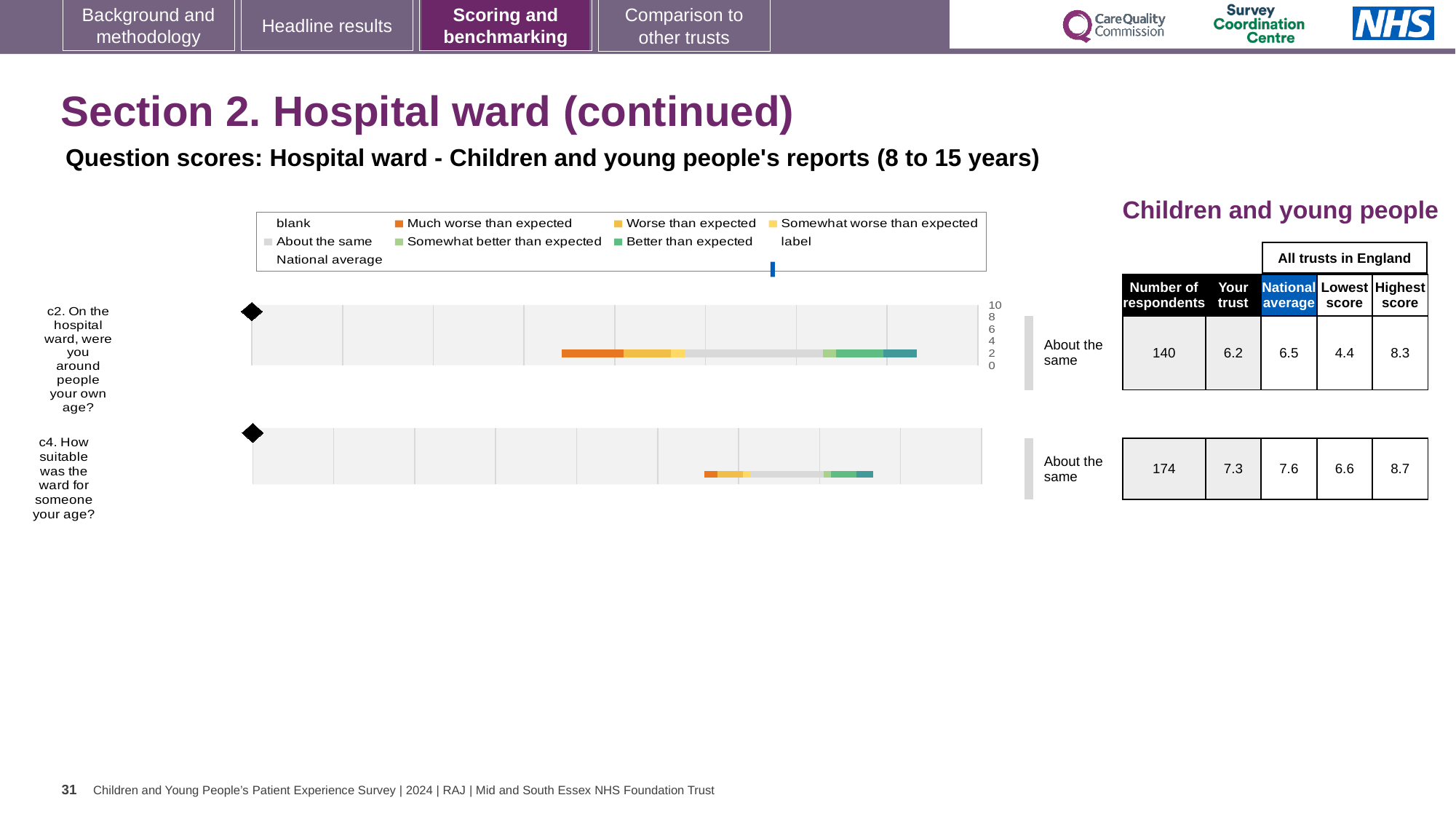
For question c2, which is larger: the 'Your trust' score or the national average? National average What benchmark category is shown for question c4? About the same What kind of chart is used to show the question scores on this slide? bar chart What is the difference between the highest and lowest scores for question c4? 2.1 What is the national average score for question c4 (How suitable was the ward for someone your age?)? 7.6 How many questions are plotted in the chart on this slide? 2 Which question has more respondents, c2 or c4? c4 What is the 'Your trust' score for question c2 (On the hospital ward, were you around people your own age?)? 6.2 How many respondents answered question c2? 140 What heading appears above the table of scores on the right of the slide? Children and young people By how much does the national average exceed the 'Your trust' score for question c2? 0.3 What is the highest score among all trusts in England for question c4? 8.7